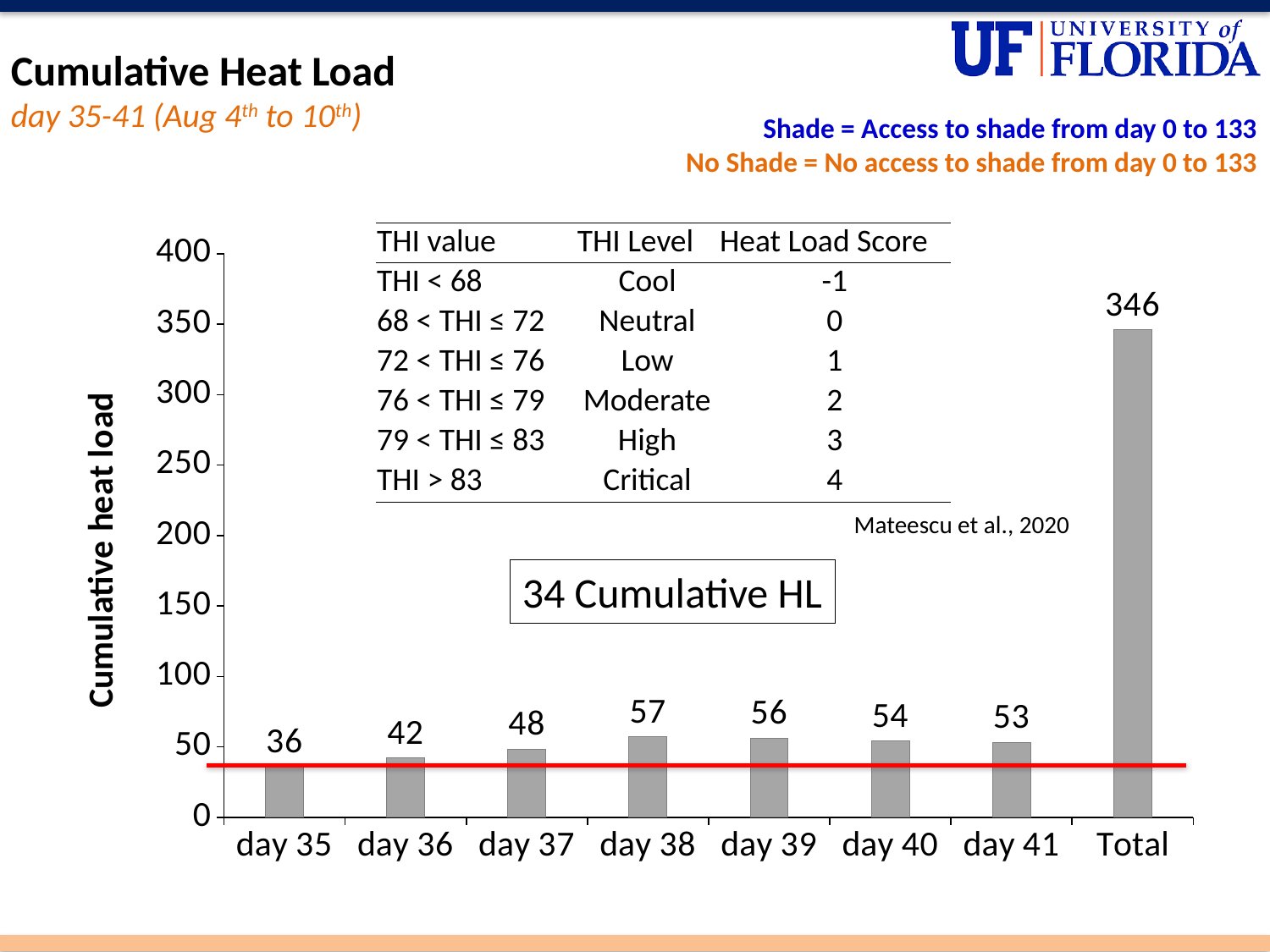
Which is larger, the value for day 36 or the value for day 40? day 40 Which day has the lowest cumulative heat load? day 35 Which category has the highest value in the chart? Total What is the cumulative heat load value for day 38? 57 How many bars are plotted in the chart? 8 Is the value for day 41 greater or less than 100? less What is the cumulative heat load value for day 35? 36 What is the difference between the values for day 38 and day 35? 21 What value is shown in the boxed label on the chart? 34 Cumulative HL What kind of chart is shown on the slide? bar chart What is the value shown for the Total bar? 346 What is the label of the y axis? Cumulative heat load